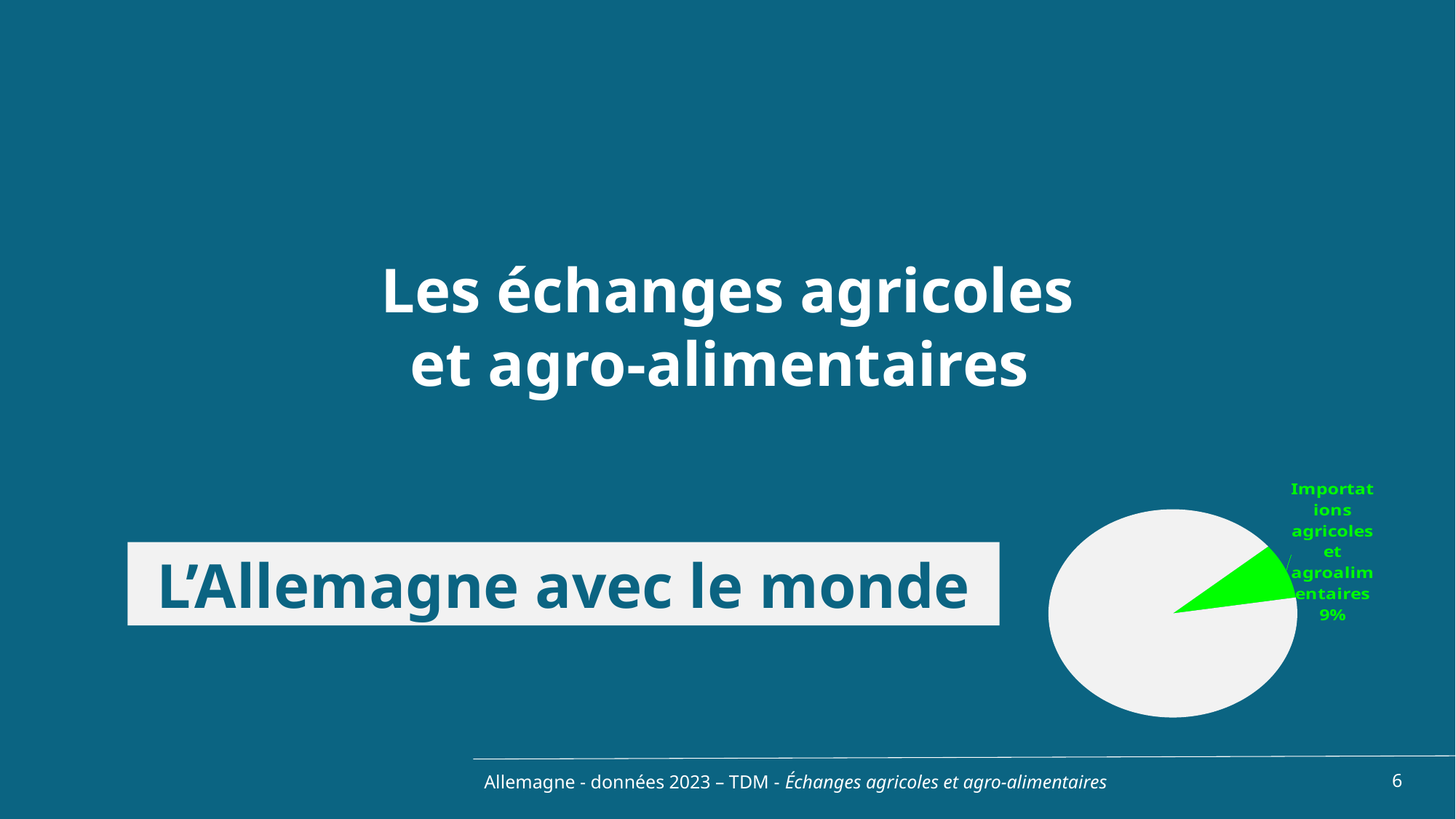
What colour is the slice labelled "Importations agricoles et agroalimentaires"? green What is the only data label printed on the pie chart? Importations agricoles et agroalimentaires 9% What kind of chart is shown on the slide? pie chart What share of the pie does the slice labelled "Importations agricoles et agroalimentaires" represent? 9% Which slice of the pie chart is the smallest? Importations agricoles et agroalimentaires How many slices does the pie chart show? 2 Which slice of the pie is larger, the green slice or the white slice? the white slice